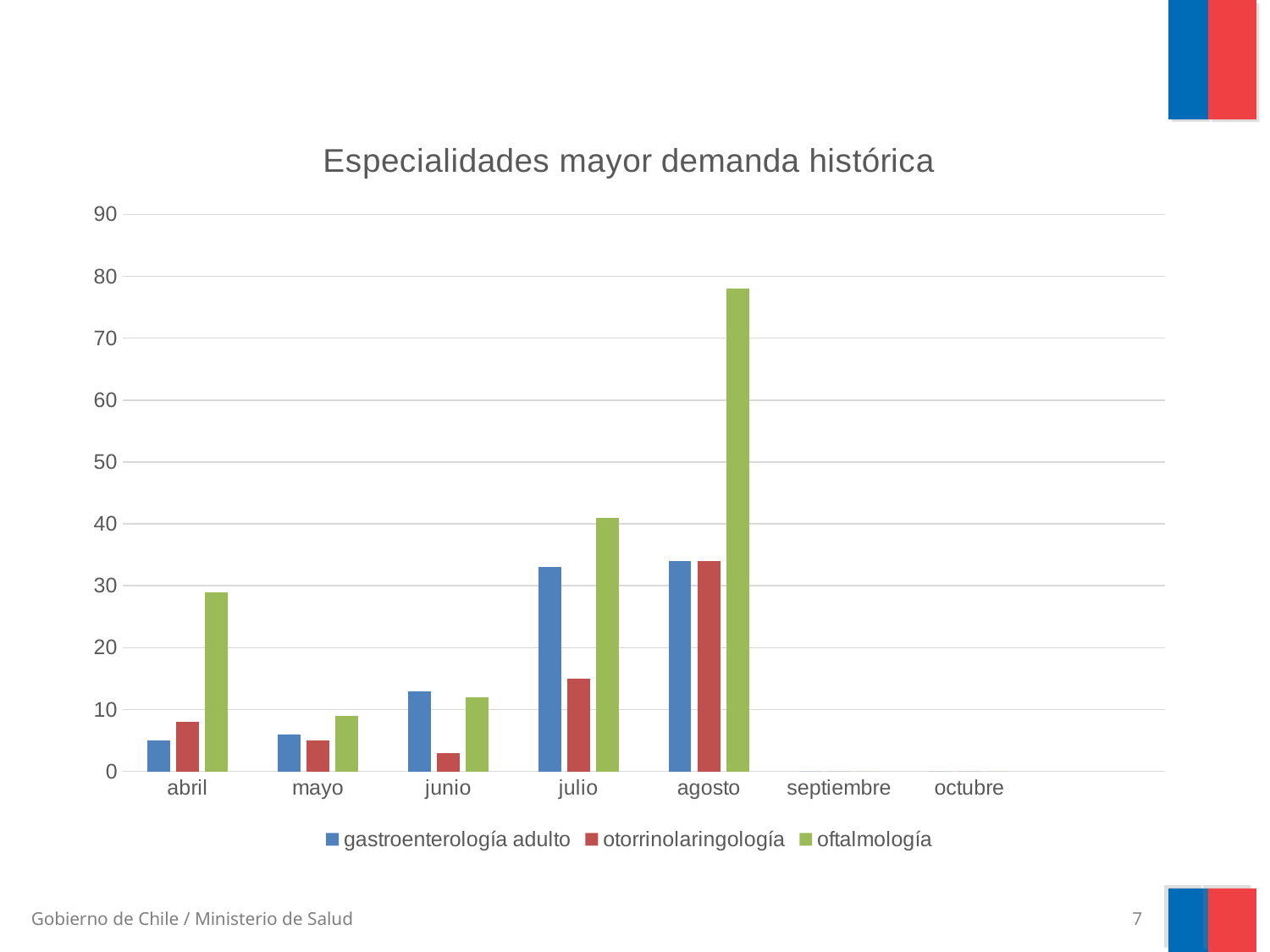
Does the value for oftalmología rise or fall from junio to agosto? rise Which series is shown in green in the legend? oftalmología Which series has the highest value in agosto? oftalmología Is the value for gastroenterología adulto in julio greater or less than 20? greater Is the value for otorrinolaringología in junio greater or less than 10? less In which month is the value for oftalmología highest? agosto What kind of chart is shown on the slide? bar chart How many months are shown on the x axis? 7 What is the title of the chart? Especialidades mayor demanda histórica Is the value for oftalmología in agosto greater or less than 70? greater In julio, which is larger: gastroenterología adulto or otorrinolaringología? gastroenterología adulto How many series does the legend list? 3